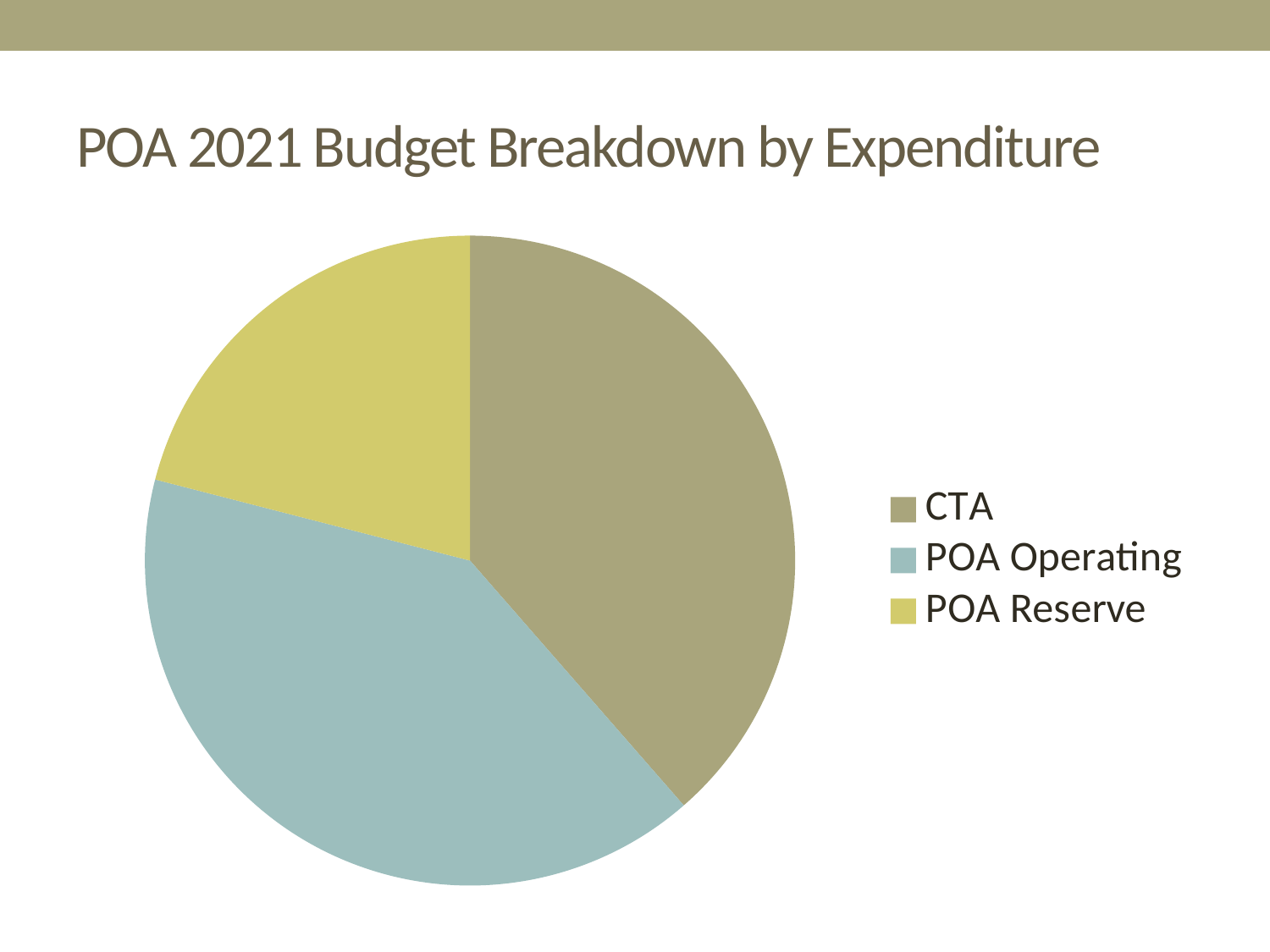
Which slice is larger, POA Operating or POA Reserve? POA Operating What colour is the POA Reserve slice? yellow How many slices does the pie chart have? 3 How many entries does the legend list? 3 Which category has the smallest slice of the pie? POA Reserve Which slice is larger, CTA or POA Reserve? CTA What is the title of the slide? POA 2021 Budget Breakdown by Expenditure What kind of chart is shown on the slide? pie chart